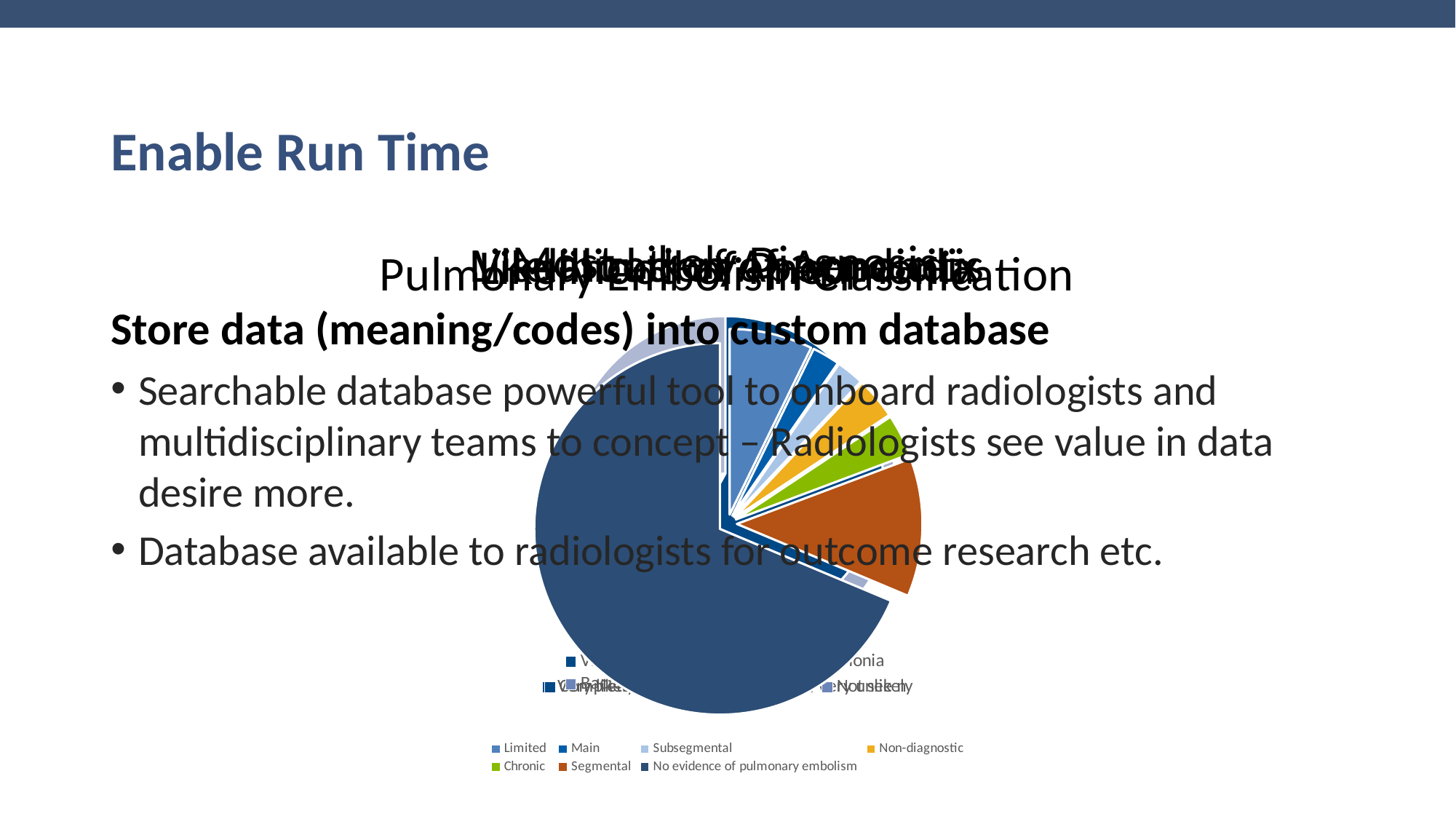
How many categories does the legend of the Pulmonary Embolism Classification pie chart list? 7 What kind of chart is the Pulmonary Embolism Classification chart? pie chart In the Pulmonary Embolism Classification pie chart, which slice is larger: Segmental or Chronic? Segmental What colour represents Segmental in the legend of the Pulmonary Embolism Classification pie chart? orange What colour represents Chronic in the legend of the Pulmonary Embolism Classification pie chart? green In the Pulmonary Embolism Classification pie chart, which slice is larger: Segmental or Non-diagnostic? Segmental In the Pulmonary Embolism Classification pie chart, which slice is larger: No evidence of pulmonary embolism or Segmental? No evidence of pulmonary embolism In the Pulmonary Embolism Classification pie chart, which category has the largest slice? No evidence of pulmonary embolism